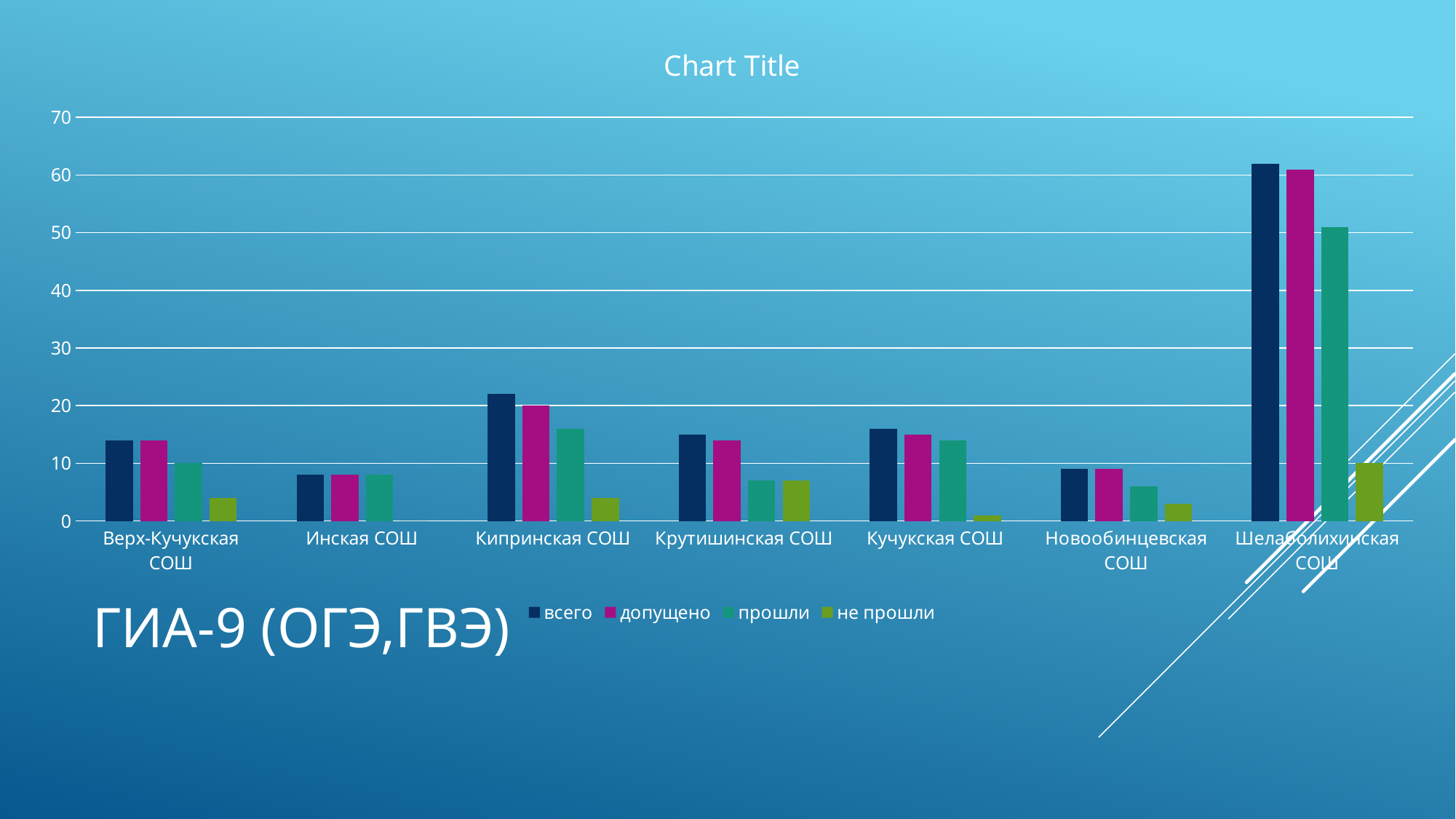
Which school has the lowest value for 'всего'? Инская СОШ Is the value for 'не прошли' at Кучукская СОШ greater or less than 10? less How many schools (categories) are shown on the x axis? 7 Which is larger: 'прошли' for Кучукская СОШ or 'прошли' for Новообинцевская СОШ? Кучукская СОШ Is the value for 'всего' at Шелаболихинская СОШ greater or less than 60? greater Which is larger: 'всего' for Кипринская СОШ or 'всего' for Крутишинская СОШ? Кипринская СОШ What is the title shown above the chart? Chart Title What kind of chart is shown on the slide? bar chart How many series does the legend list? 4 Which school has the highest value for 'всего'? Шелаболихинская СОШ Is the value for 'всего' at Кипринская СОШ greater or less than 20? greater